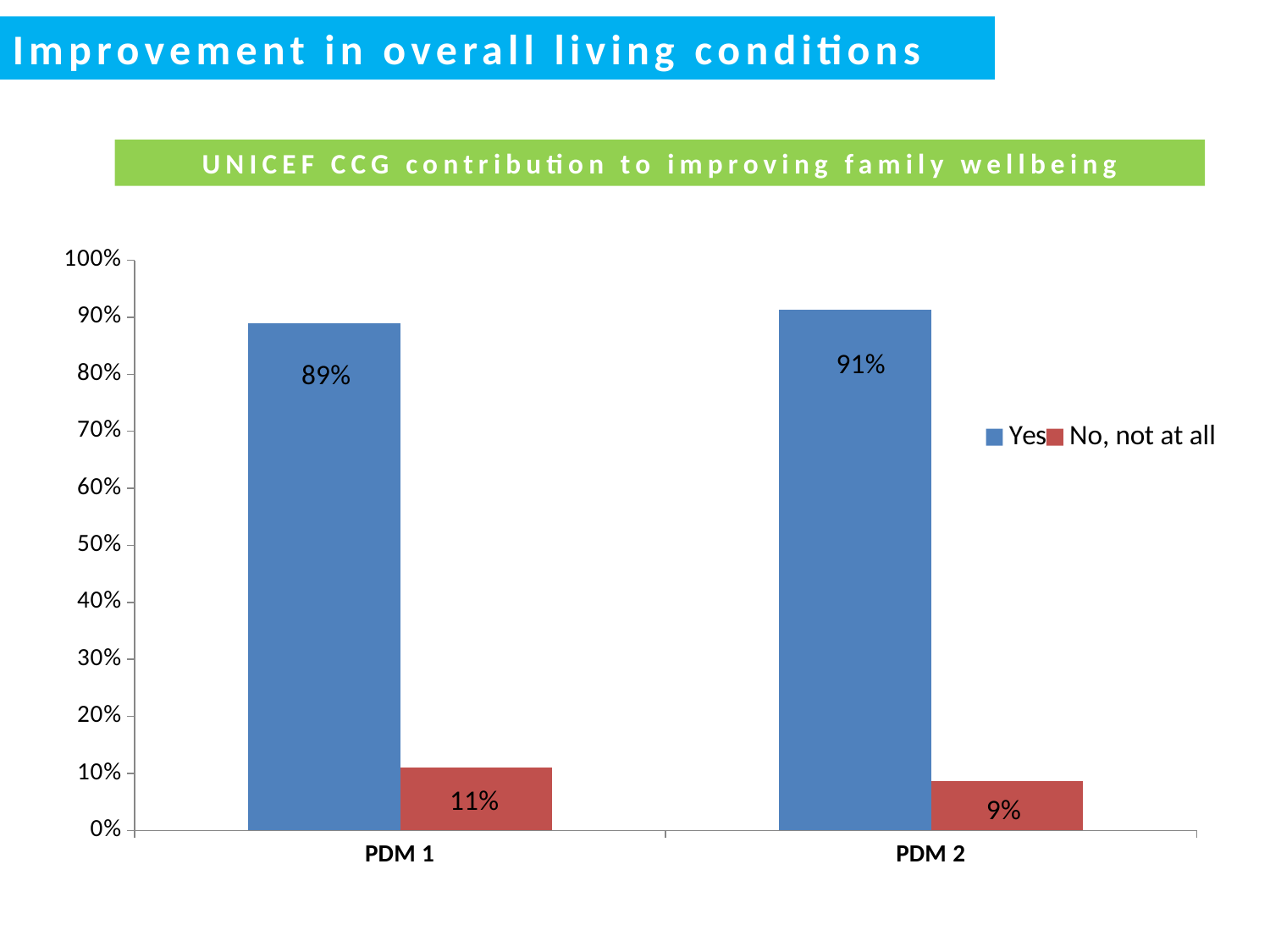
How many categories are shown on the x axis? 2 Which category has the lowest No, not at all value? PDM 2 What colour are the Yes bars? Blue What is the value for Yes in PDM 1? 89% How many series does the legend list? 2 What is the difference between the Yes values for PDM 2 and PDM 1? 2% Which is larger: the Yes value for PDM 1 or the No, not at all value for PDM 1? Yes Which category has the highest Yes value? PDM 2 What is the value for No, not at all in PDM 2? 9% What is the value for Yes in PDM 2? 91% What is the value for No, not at all in PDM 1? 11% What kind of chart is shown on the slide? Bar chart